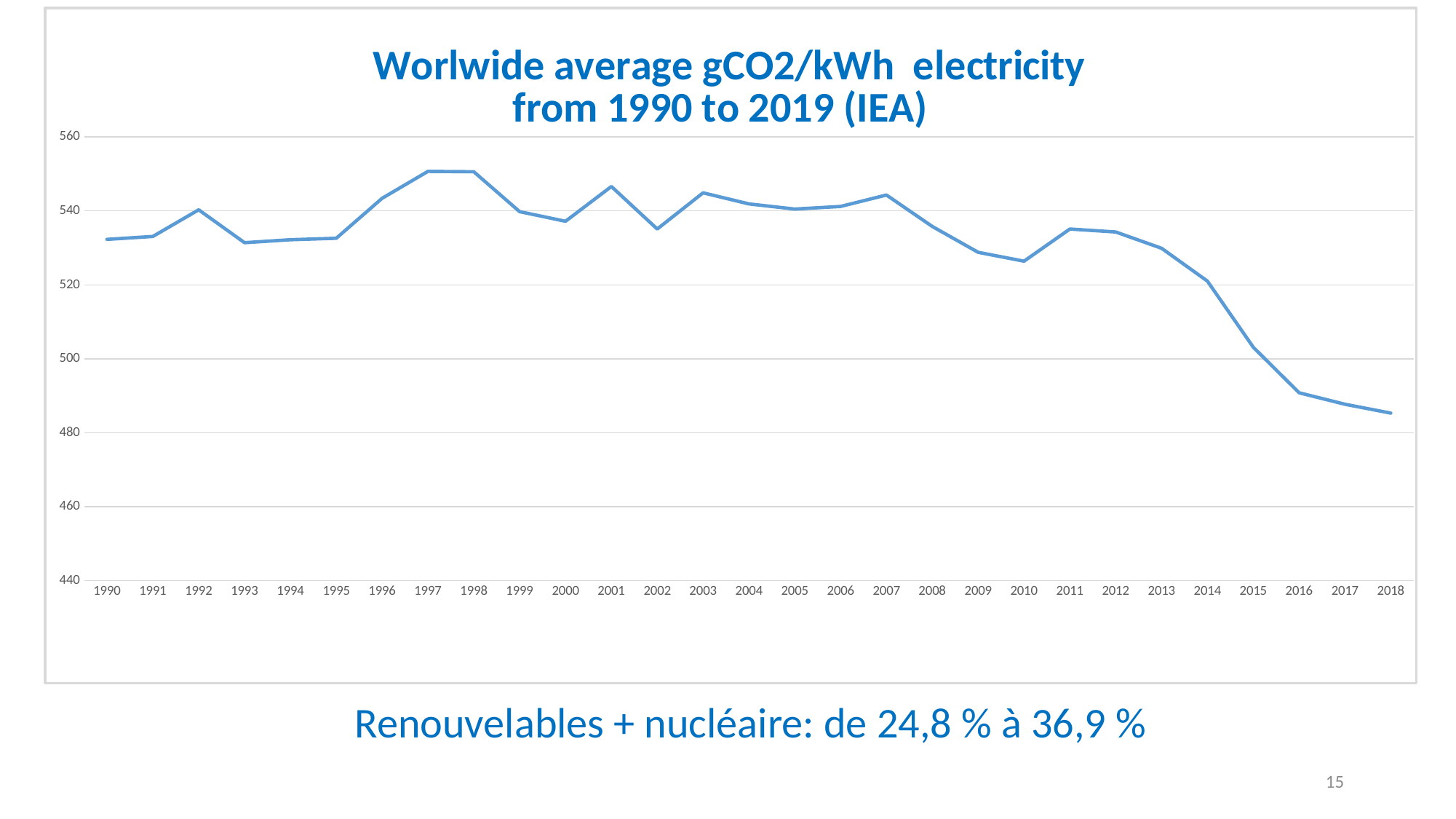
Is the value for 2018 greater or less than 500? less Which year has the lowest value on the chart? 2018 Is the value for 1997 greater or less than 540? greater What is the title of the chart? Worlwide average gCO2/kWh electricity from 1990 to 2019 (IEA) Is the value for 2010 greater or less than 520? greater Which year has the larger value, 1990 or 2018? 1990 What kind of chart is shown on the slide? line chart How many years are plotted along the x axis of the chart? 29 Do the values rise or fall from 2013 to 2018? fall Which year has the larger value, 2001 or 2002? 2001